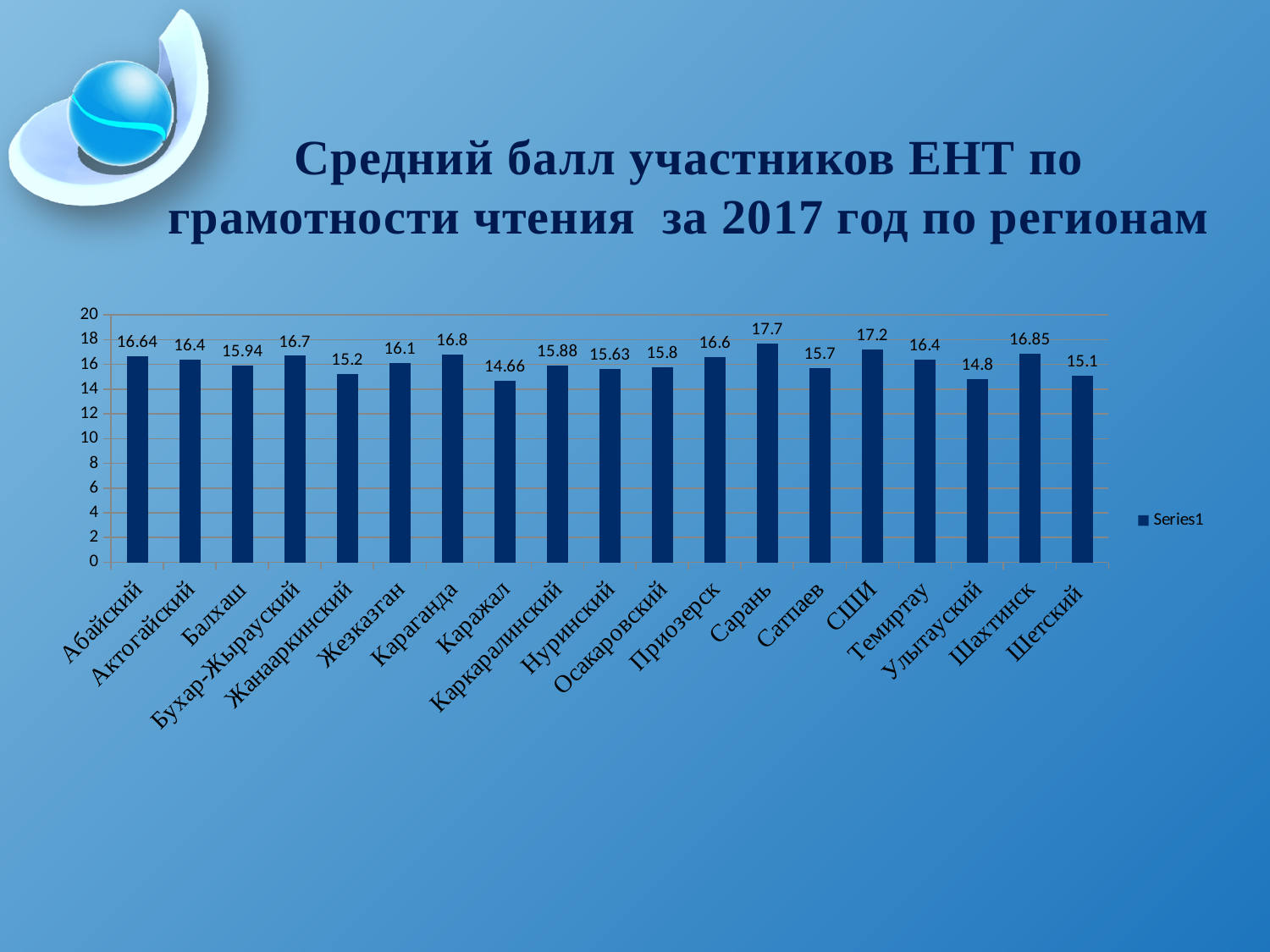
What is the average score for Сарань? 17.7 What is the value shown for Шахтинск? 16.85 How many series does the legend list? 1 Which has a higher value, Караганда or Жезказган? Караганда How many regions are shown on the chart? 19 What is the difference between the values for Сарань and Каражал? 3.04 What is the difference between the values for СШИ and Темиртау? 0.8 Which region has the lowest average score? Каражал Which has a lower value, Улытауский or Шетский? Улытауский What type of chart is shown on the slide? Bar chart Which region has the highest average score? Сарань What is the value shown for Каражал? 14.66